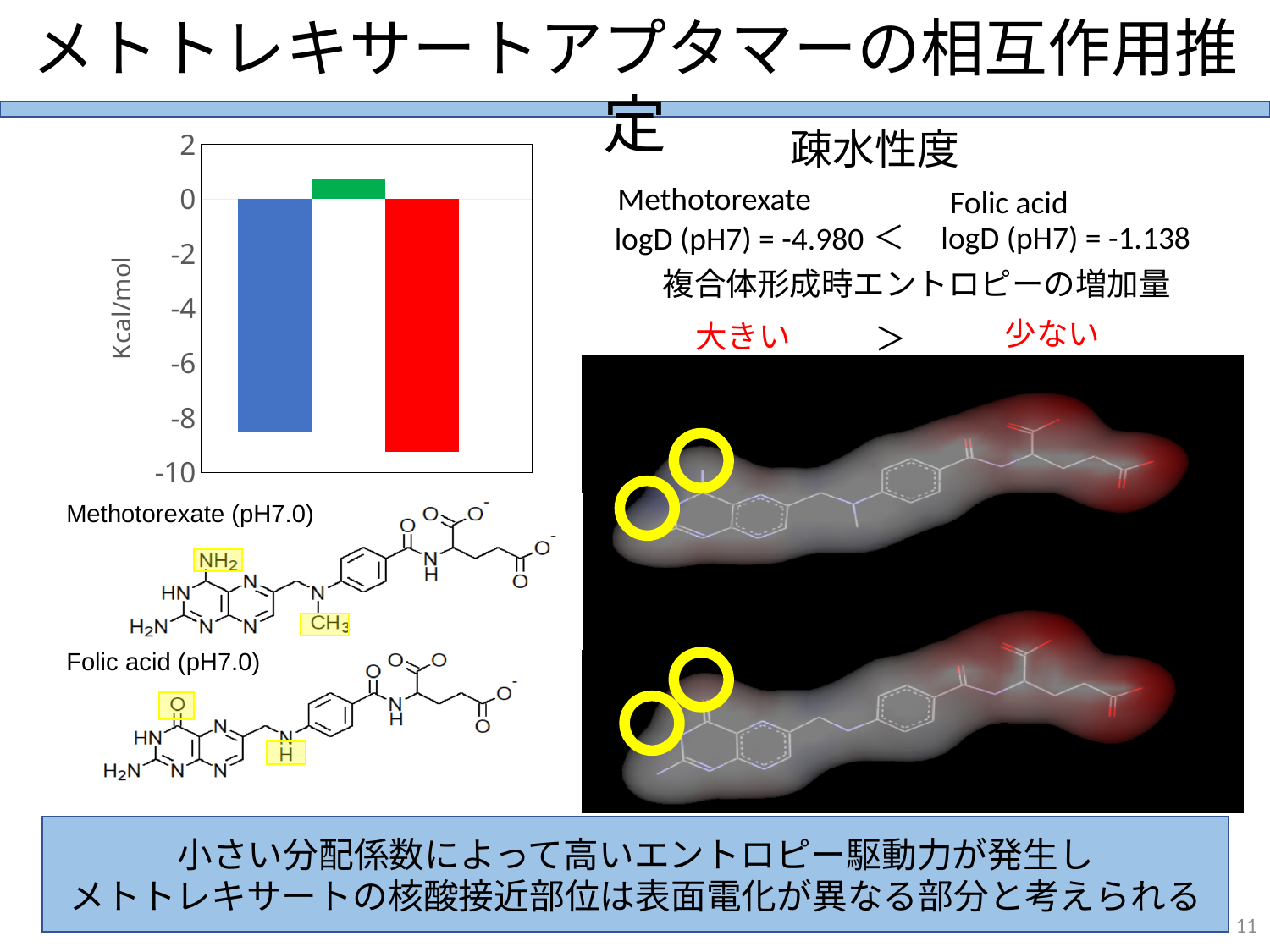
Is the value of the red bar greater or less than -10? greater What is the label on the vertical axis of the bar chart? Kcal/mol What kind of chart is shown on the left of the slide? bar chart What is the highest tick value shown on the vertical axis of the bar chart? 2 Is the value of the blue bar greater or less than -8? less Is the value of the red bar greater or less than -8? less How many bars in the chart have a positive value? 1 Which is larger, the value of the blue bar or the value of the green bar? the green bar Which bar in the chart has the lowest value? the red bar Which bar in the chart has the highest value? the green bar How many bars are plotted in the bar chart? 3